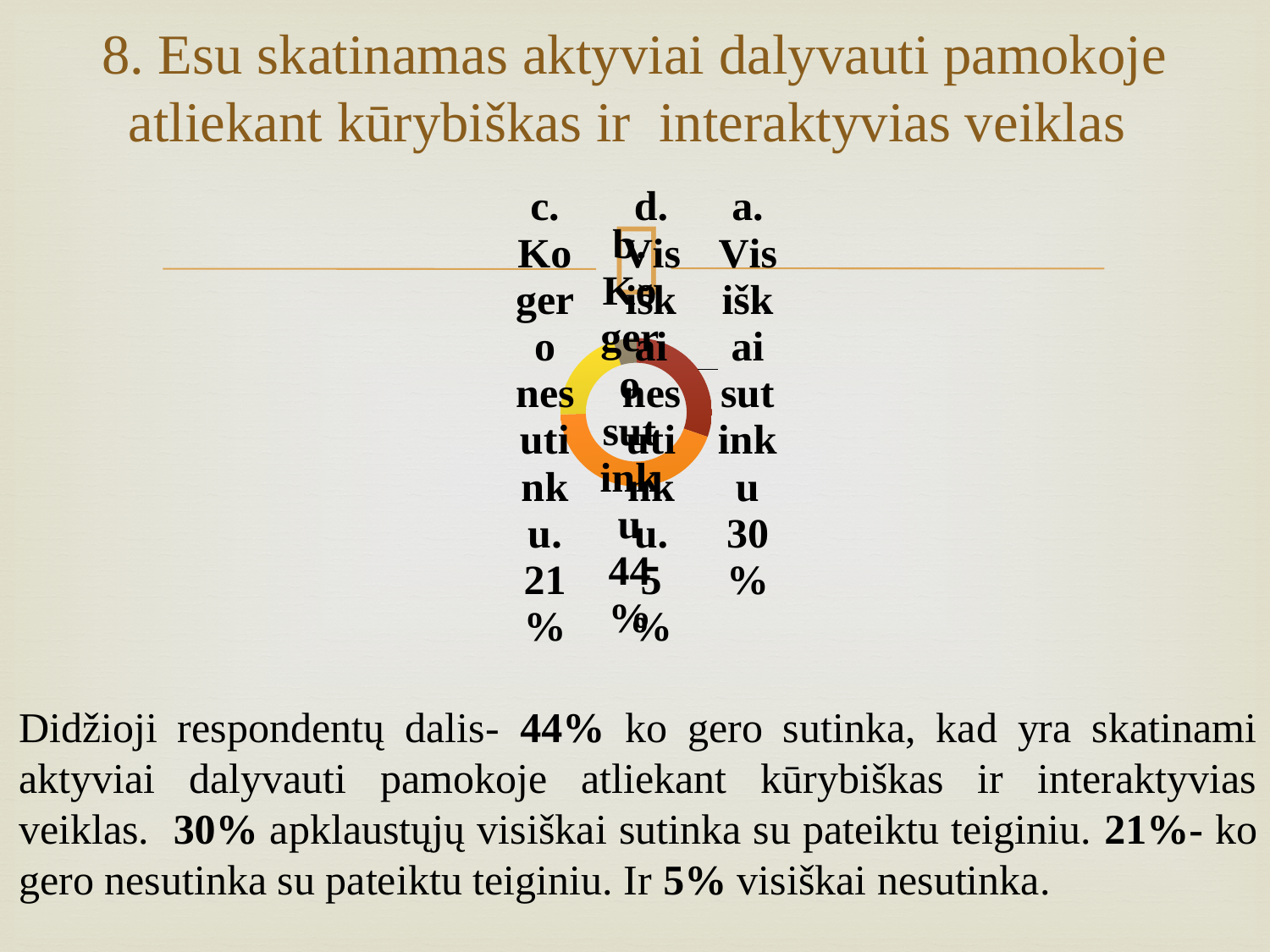
What percentage of respondents answered "a. Visiškai sutinku"? 30% Which answer option has the largest share in the chart? b. Ko gero sutinku What is the difference in percentage points between "c. Ko gero nesutinku" and "d. Visiškai nesutinku"? 16 Which answer option has the smallest share in the chart? d. Visiškai nesutinku What percentage of respondents answered "d. Visiškai nesutinku"? 5% What percentage of respondents answered "b. Ko gero sutinku"? 44% What kind of chart is shown on the slide? doughnut chart What is the difference in percentage points between "b. Ko gero sutinku" and "a. Visiškai sutinku"? 14 What is the combined share of respondents who agree ("a. Visiškai sutinku" plus "b. Ko gero sutinku")? 74% What percentage of respondents answered "c. Ko gero nesutinku"? 21% How many answer categories does the chart show? 4 Which is larger: the share for "c. Ko gero nesutinku" or the share for "d. Visiškai nesutinku"? c. Ko gero nesutinku